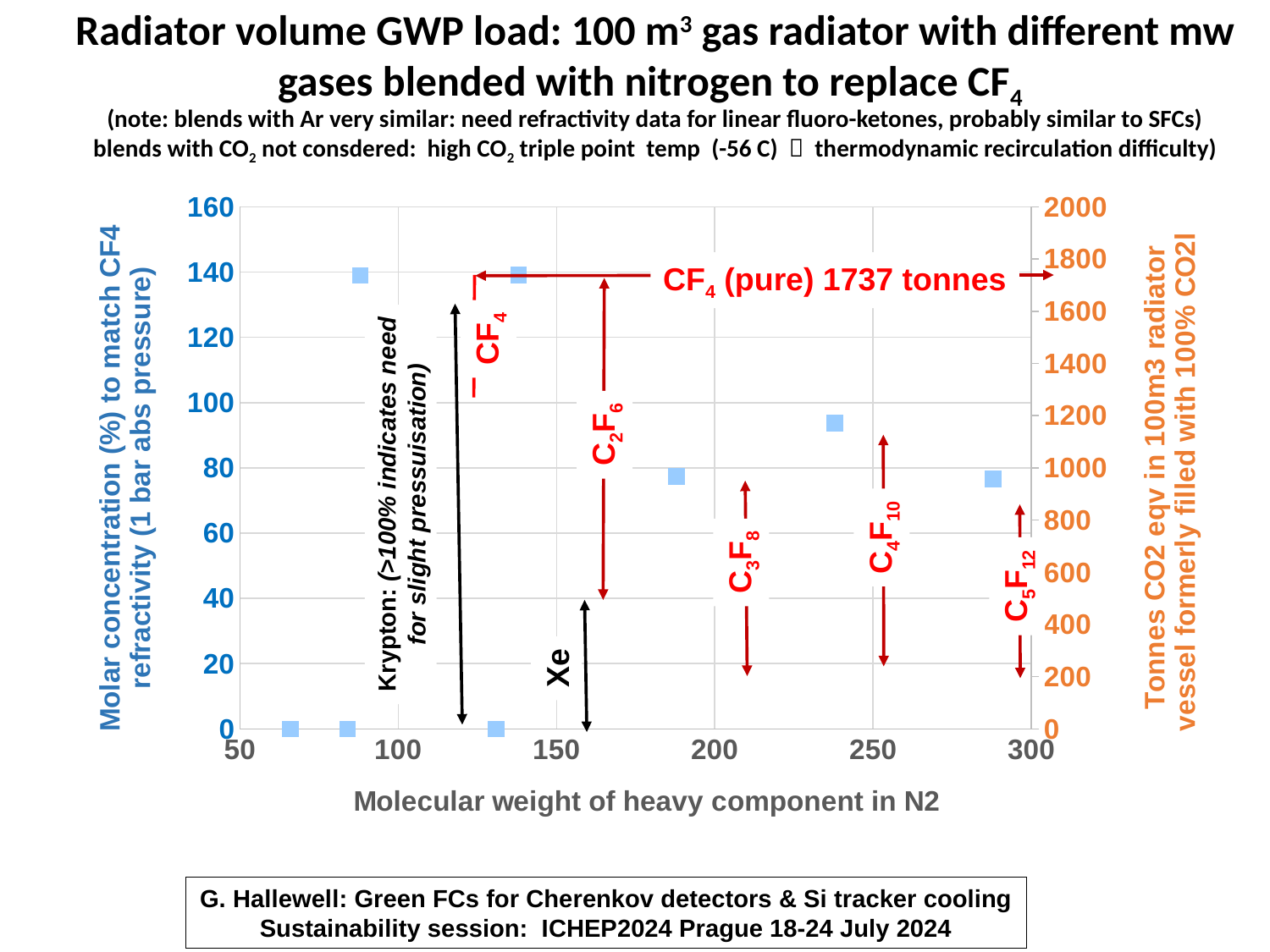
What kind of chart is shown on the slide? scatter chart According to the annotation, how many tonnes of CO2 equivalent does pure CF4 correspond to? 1737 tonnes How many plotted points lie on the 0 line of the left axis? 3 What is the maximum value shown on the right-hand (orange) axis? 2000 What is the title of the x axis? Molecular weight of heavy component in N2 How many data points are plotted on the chart? 8